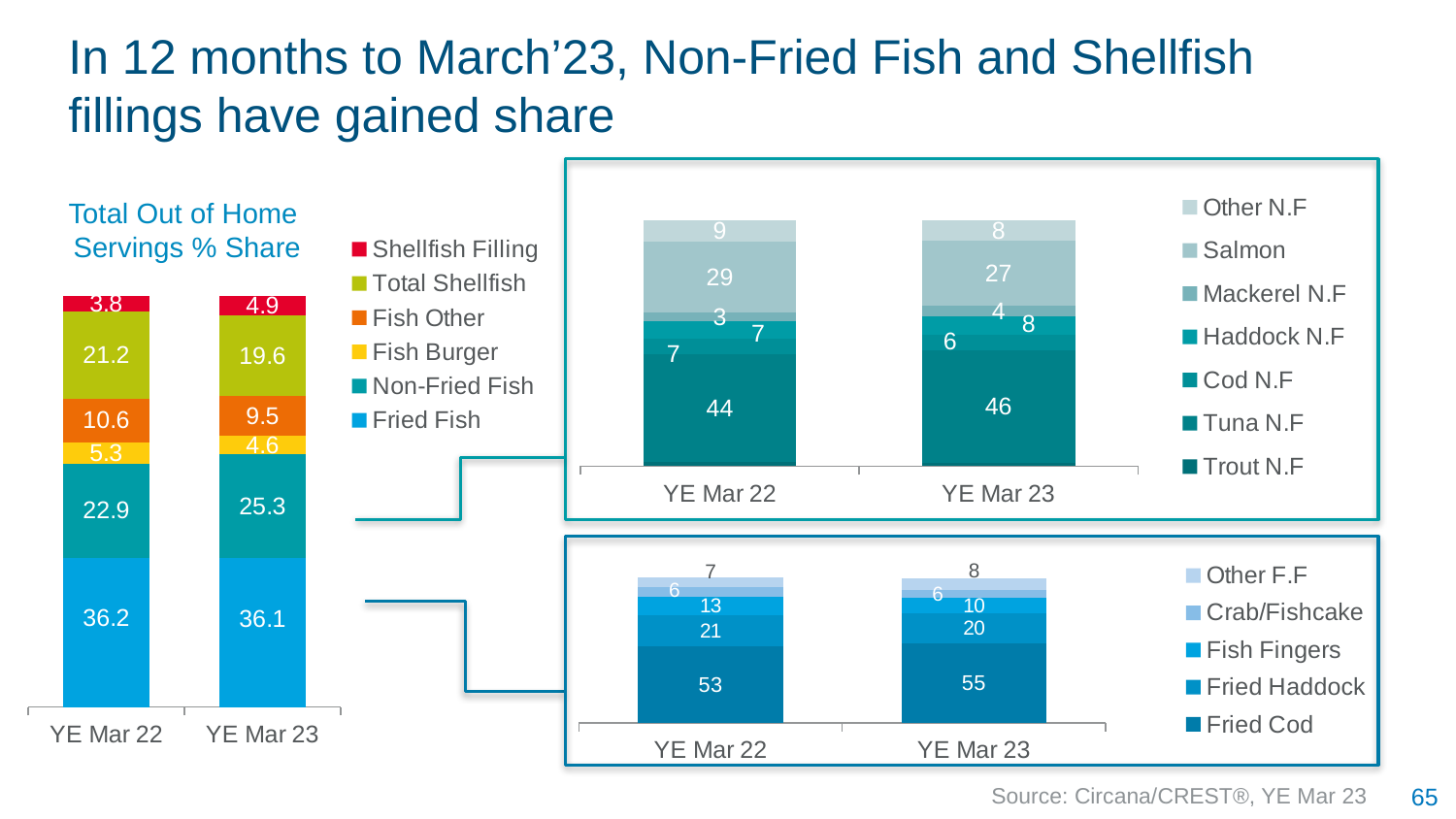
What type of chart is the Total Out of Home Servings % Share chart on the left? Stacked bar chart In the Total Out of Home Servings % Share chart on the left, how many series does the legend list? 6 In the bottom-right chart (Fried Fish breakdown), by how much did Fish Fingers fall from YE Mar 22 to YE Mar 23? 3 In the Total Out of Home Servings % Share chart on the left, what is the value for Total Shellfish in YE Mar 22? 21.2 In the bottom-right chart (Fried Fish breakdown), what is the value for Fish Fingers in YE Mar 22? 13 In the bottom-right chart (Fried Fish breakdown), what is the value for Fried Cod in YE Mar 23? 55 In the Total Out of Home Servings % Share chart on the left, is the Fish Other share larger in YE Mar 22 or YE Mar 23? YE Mar 22 In the Total Out of Home Servings % Share chart on the left, which series has the largest share in YE Mar 23? Fried Fish In the top-right chart (Non-Fried Fish breakdown), what is the value for Salmon in YE Mar 22? 29 In the Total Out of Home Servings % Share chart on the left, by how much did the Non-Fried Fish share increase from YE Mar 22 to YE Mar 23? 2.4 In the Total Out of Home Servings % Share chart on the left, what is the value for Non-Fried Fish in YE Mar 23? 25.3 In the bottom-right chart (Fried Fish breakdown), how many series does the legend list? 5